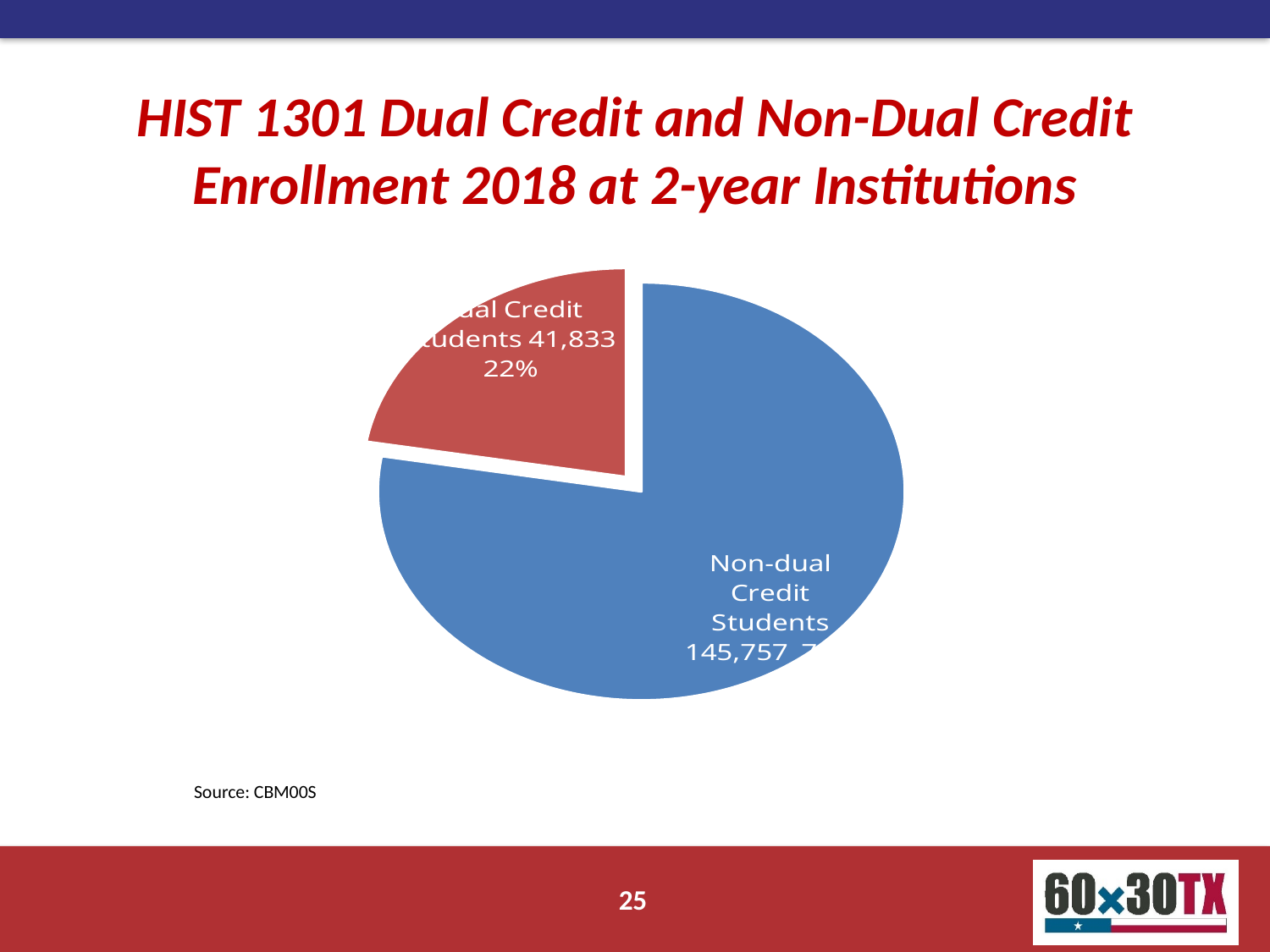
What colour is the Dual Credit Students slice? red Does the Dual Credit Students slice represent more or less than half of the pie? less What kind of chart is shown on the slide? pie chart What is the title of the slide's chart? HIST 1301 Dual Credit and Non-Dual Credit Enrollment 2018 at 2-year Institutions How many Non-dual Credit Students are shown in the pie chart? 145,757 Which group has the larger slice of the pie? Non-dual Credit Students What percentage of the pie do Dual Credit Students represent? 22% Which group has the smaller slice of the pie? Dual Credit Students How many slices does the pie chart have? 2 Which is larger: the number of Dual Credit Students or the number of Non-dual Credit Students? Non-dual Credit Students What is the difference between the number of Non-dual Credit Students and Dual Credit Students? 103,924 How many Dual Credit Students are shown in the pie chart? 41,833